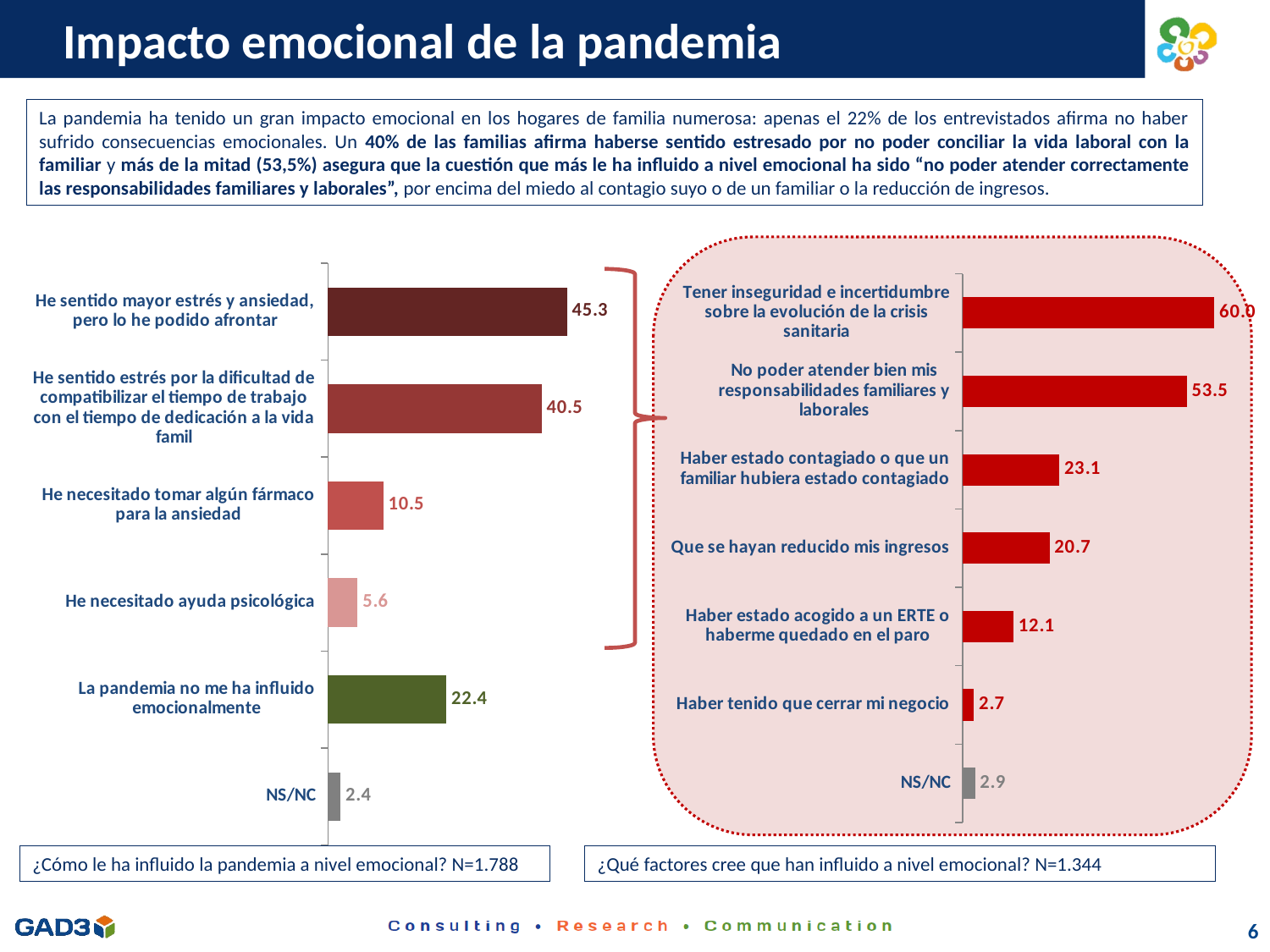
In the right chart (¿Qué factores cree que han influido a nivel emocional?), which category has the lowest value? Haber tenido que cerrar mi negocio In the left chart (¿Cómo le ha influido la pandemia a nivel emocional?), what is the value for 'La pandemia no me ha influido emocionalmente'? 22.4 In the right chart (¿Qué factores cree que han influido a nivel emocional?), which is larger: 'Haber estado contagiado o que un familiar hubiera estado contagiado' or 'Que se hayan reducido mis ingresos'? Haber estado contagiado o que un familiar hubiera estado contagiado In the right chart (¿Qué factores cree que han influido a nivel emocional?), what is the value for 'No poder atender bien mis responsabilidades familiares y laborales'? 53.5 In the right chart (¿Qué factores cree que han influido a nivel emocional?), which category has the highest value? Tener inseguridad e incertidumbre sobre la evolución de la crisis sanitaria In the left chart (¿Cómo le ha influido la pandemia a nivel emocional?), what is the difference between 'He necesitado tomar algún fármaco para la ansiedad' and 'He necesitado ayuda psicológica'? 4.9 In the left chart (¿Cómo le ha influido la pandemia a nivel emocional?), how many categories are shown? 6 In the left chart (¿Cómo le ha influido la pandemia a nivel emocional?), which category has the lowest value? NS/NC In the right chart (¿Qué factores cree que han influido a nivel emocional?), what is the value for 'Haber estado acogido a un ERTE o haberme quedado en el paro'? 12.1 What type of chart is the left chart (¿Cómo le ha influido la pandemia a nivel emocional?)? Bar chart In the right chart (¿Qué factores cree que han influido a nivel emocional?), how many categories are shown? 7 In the left chart (¿Cómo le ha influido la pandemia a nivel emocional?), what is the value for 'He sentido mayor estrés y ansiedad, pero lo he podido afrontar'? 45.3